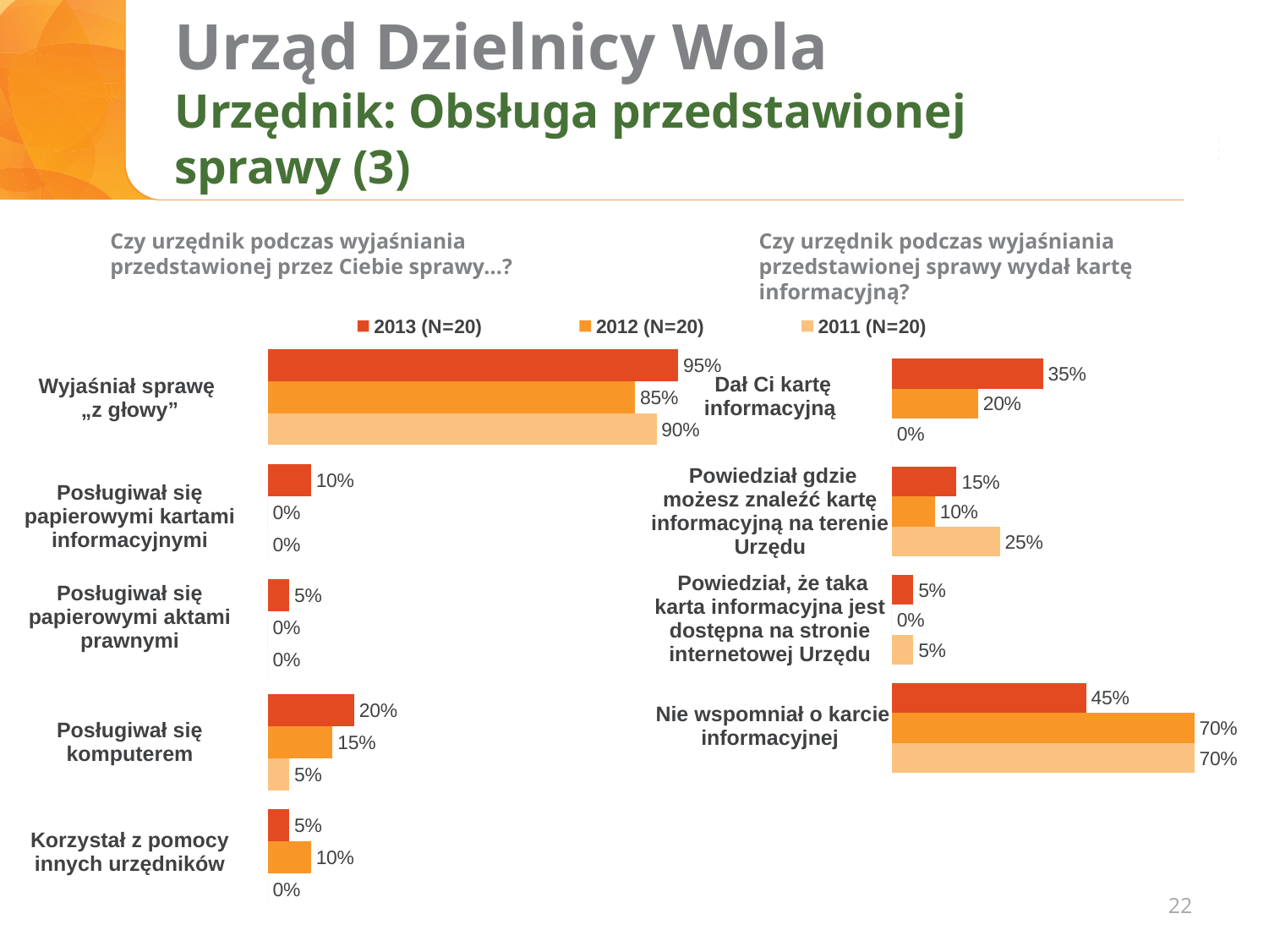
In the right chart, what is the 2013 value for "Nie wspomniał o karcie informacyjnej"? 45% In the right chart, what is the difference between the 2013 and 2012 values for "Dał Ci kartę informacyjną"? 15% How many series does the legend list? 3 In the right chart, which category has the lowest 2012 value? Powiedział, że taka karta informacyjna jest dostępna na stronie internetowej Urzędu How many categories does the left chart show? 5 In the left chart, what is the 2012 value for "Posługiwał się komputerem"? 15% In the left chart, which category has the highest 2013 value? Wyjaśniał sprawę „z głowy” What type of chart is used on this slide? Bar chart In the left chart ("Czy urzędnik podczas wyjaśniania przedstawionej przez Ciebie sprawy...?"), what is the 2013 value for "Wyjaśniał sprawę „z głowy”"? 95% In the left chart, which is larger for "Wyjaśniał sprawę „z głowy”": the 2012 value or the 2011 value? 2011 In the right chart ("Czy urzędnik podczas wyjaśniania przedstawionej sprawy wydał kartę informacyjną?"), what is the 2011 value for "Powiedział gdzie możesz znaleźć kartę informacyjną na terenie Urzędu"? 25% In the right chart, what is the difference between the 2012 and 2013 values for "Nie wspomniał o karcie informacyjnej"? 25%